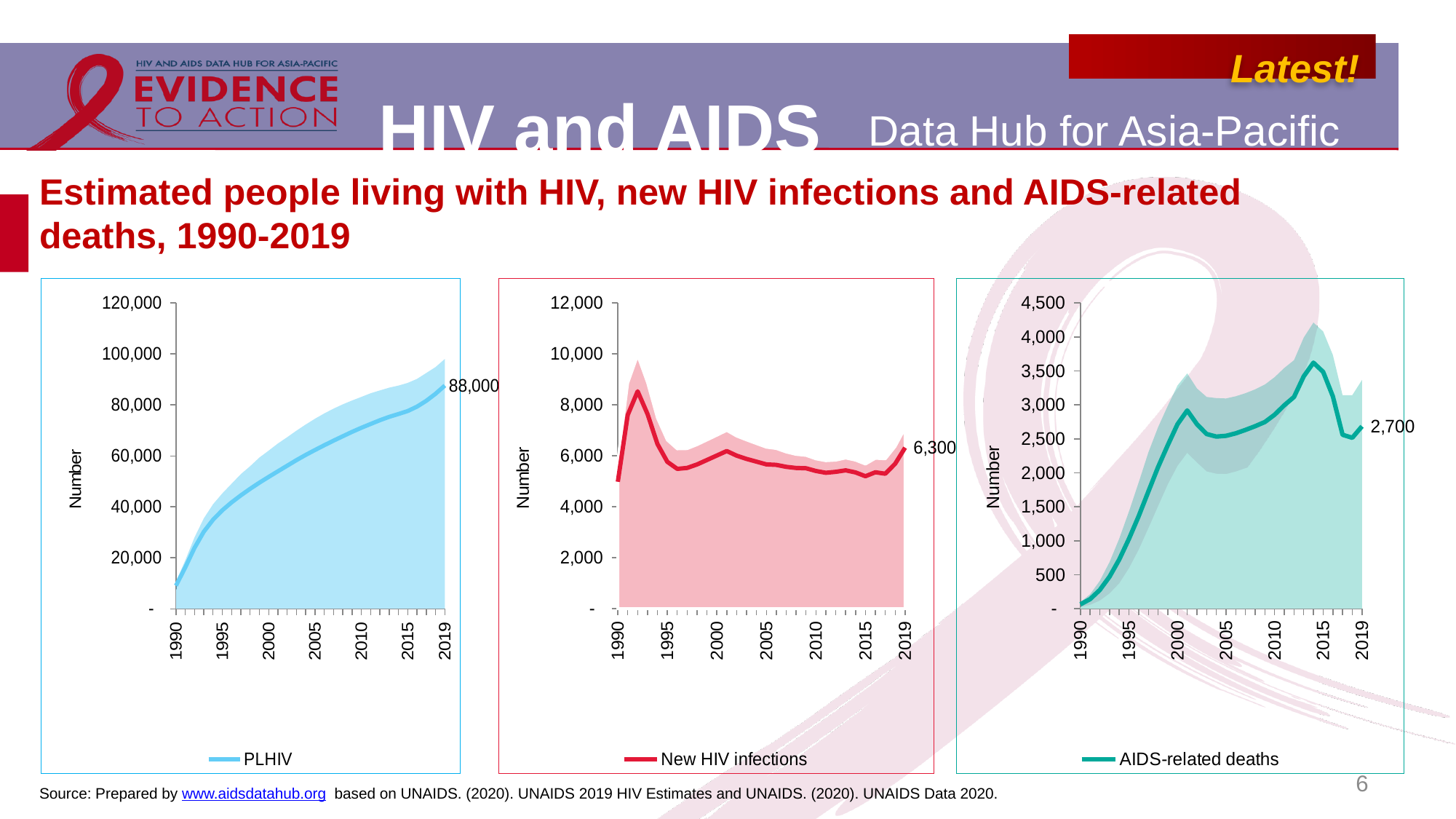
In the PLHIV chart on the left, what is the value labelled for 2019? 88,000 In the PLHIV chart on the left, is the value for 2000 greater or less than 40,000? greater How many series does the legend of the New HIV infections chart in the middle list? 1 In the PLHIV chart on the left, do the values rise or fall from 1990 to 2019? rise In the New HIV infections chart in the middle, is the value for 2010 greater or less than 8,000? less What is the legend entry of the chart on the right? AIDS-related deaths In the AIDS-related deaths chart on the right, is the value for 2015 greater or less than 3,000? greater In the AIDS-related deaths chart on the right, what is the value labelled for 2019? 2,700 What kind of chart is the PLHIV chart on the left? area and line chart (a line with a shaded area band) In the New HIV infections chart in the middle, what is the value labelled for 2019? 6,300